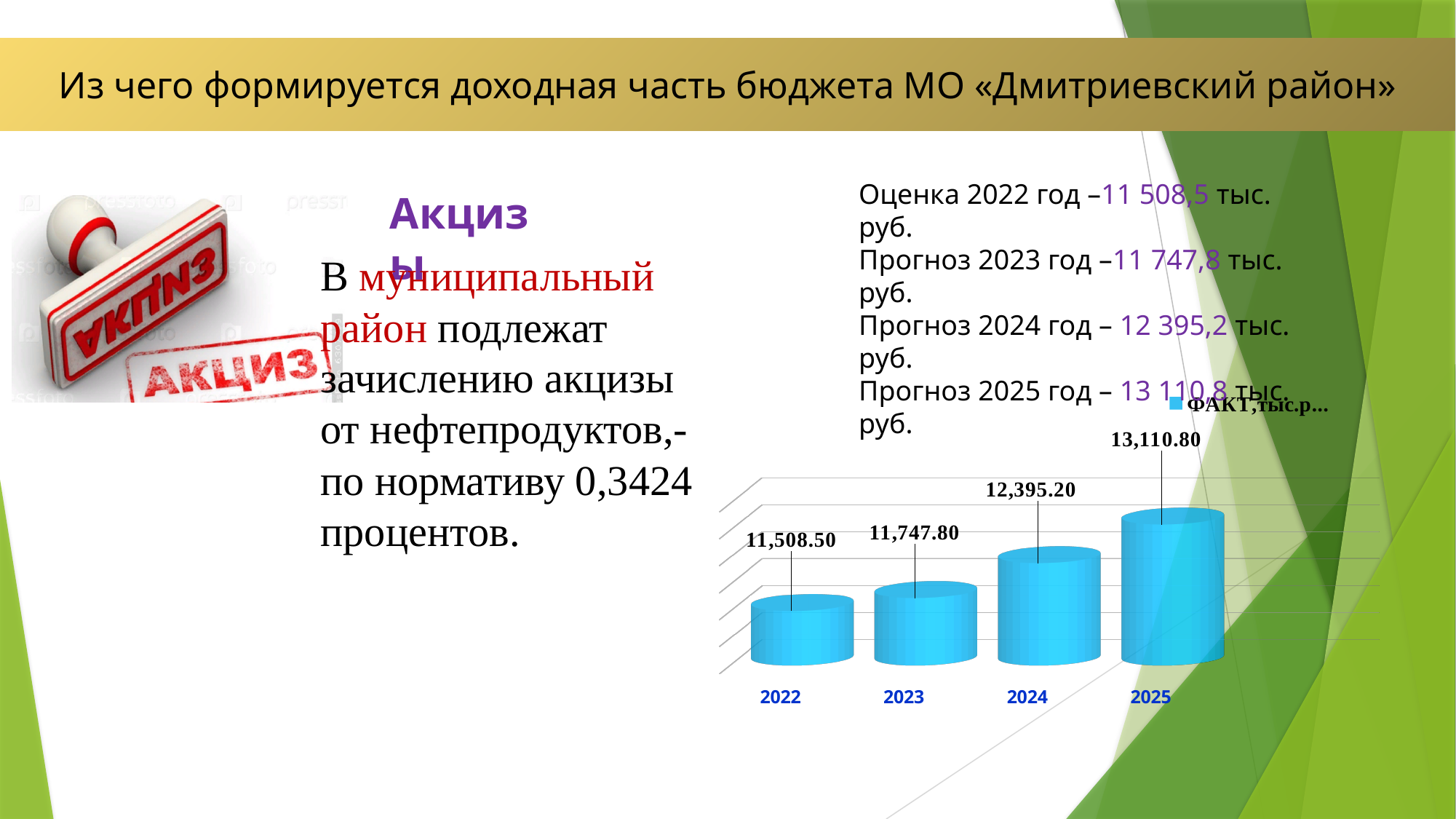
Which year has the highest value on the chart? 2025 What is the difference between the values for 2024 and 2023? 647.40 Which year has the lowest value on the chart? 2022 What kind of chart is shown on the slide? Bar chart What is the value shown for 2024 on the chart? 12,395.20 Do the values on the chart rise or fall from 2022 to 2025? Rise What is the difference between the values for 2025 and 2022? 1,602.30 How many years are shown on the chart's x axis? 4 What is the value shown for 2025 on the chart? 13,110.80 What is the value shown for 2023 on the chart? 11,747.80 What is the value shown for 2022 on the chart? 11,508.50 Which is larger, the value for 2023 or the value for 2024? 2024